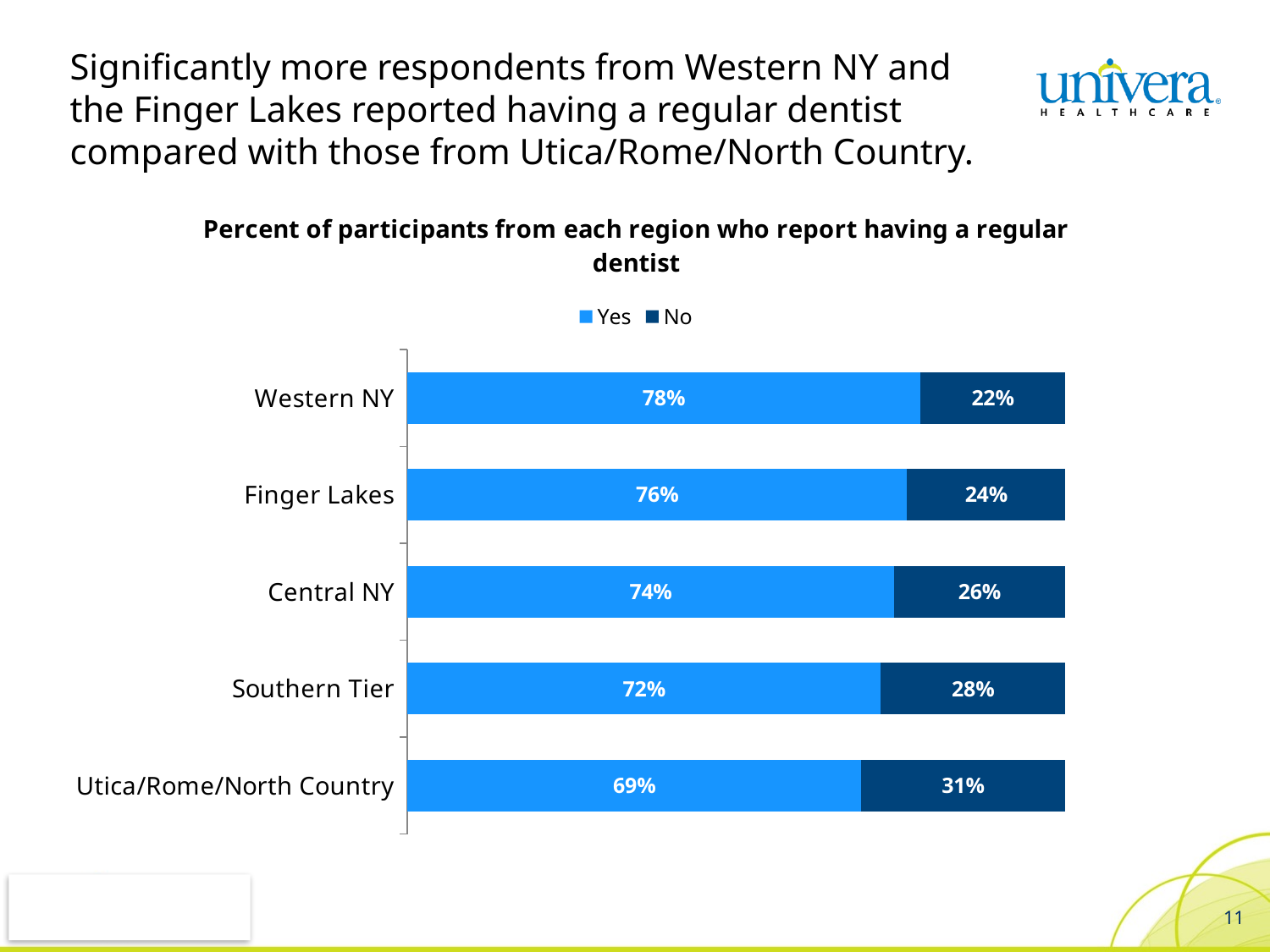
How many series does the legend list? 2 What are the two legend entries in the chart? Yes and No What kind of chart is shown on the slide? Stacked bar chart How many regions are shown in the chart? 5 Which region has the highest 'Yes' percentage? Western NY Which region has the lowest 'Yes' percentage? Utica/Rome/North Country What is the difference in 'Yes' percentage between Western NY and Utica/Rome/North Country? 9 percentage points What is the 'No' value for Utica/Rome/North Country? 31% What is the total of the Yes and No values for Southern Tier? 100% Which has a larger 'No' percentage, Finger Lakes or Southern Tier? Southern Tier What percentage of Western NY participants report having a regular dentist (Yes)? 78% What is the 'Yes' value for Central NY? 74%